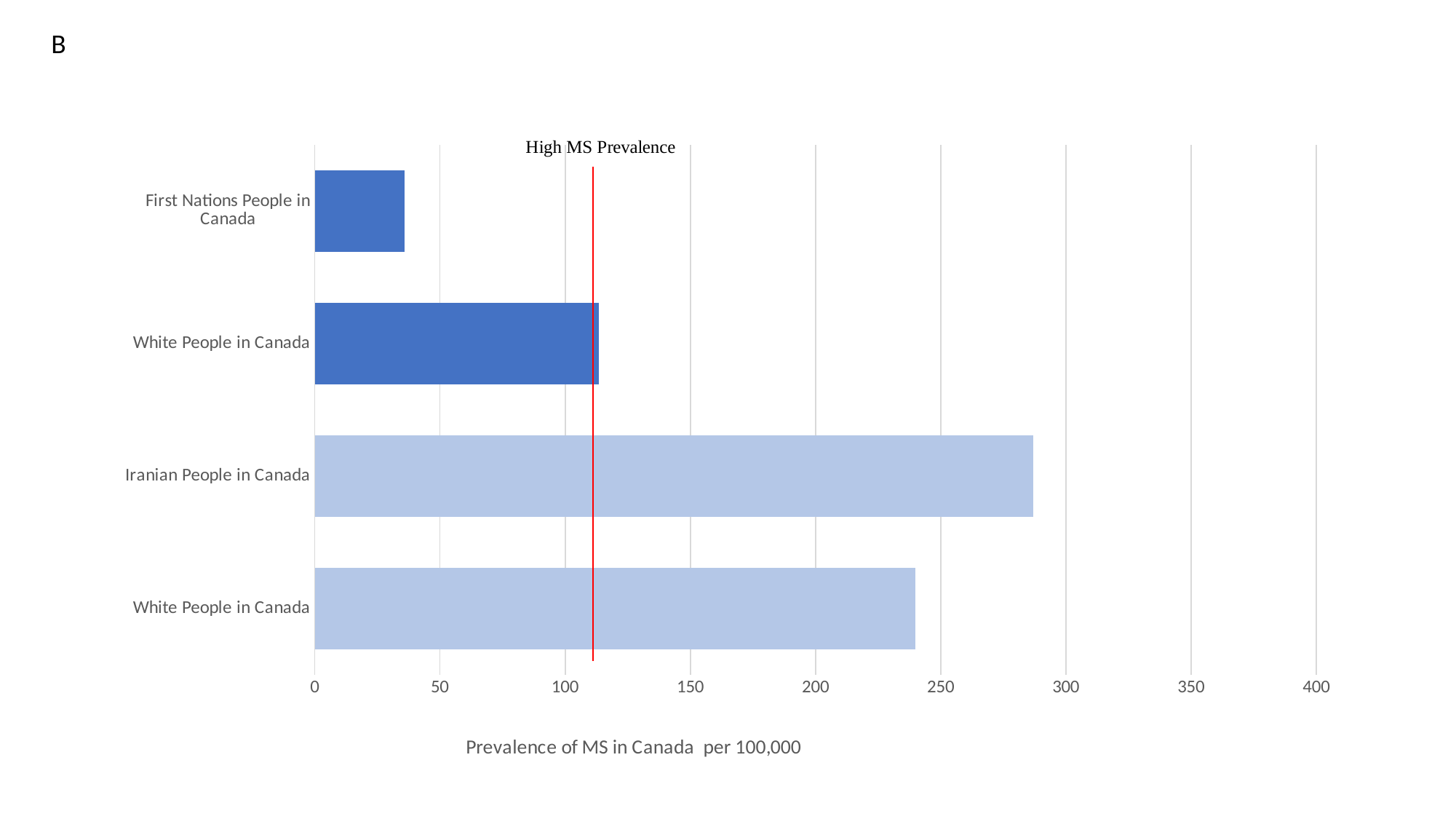
What label is given to the red vertical line in the chart? High MS Prevalence Is the value for the second bar from the top (White People in Canada) greater or less than 150? less Which is larger, the value for Iranian People in Canada or the value for First Nations People in Canada? Iranian People in Canada Is the value for Iranian People in Canada greater or less than 250? greater Which is larger, the value for the bottom bar (White People in Canada) or the value for the second bar from the top (White People in Canada)? the bottom bar Which category has the lowest prevalence of MS in the chart? First Nations People in Canada Is the value for First Nations People in Canada greater or less than 50? less What kind of chart is shown on the slide? bar chart Which category has the highest prevalence of MS in the chart? Iranian People in Canada What is the title of the horizontal axis? Prevalence of MS in Canada per 100,000 How many bars are plotted in the chart? 4